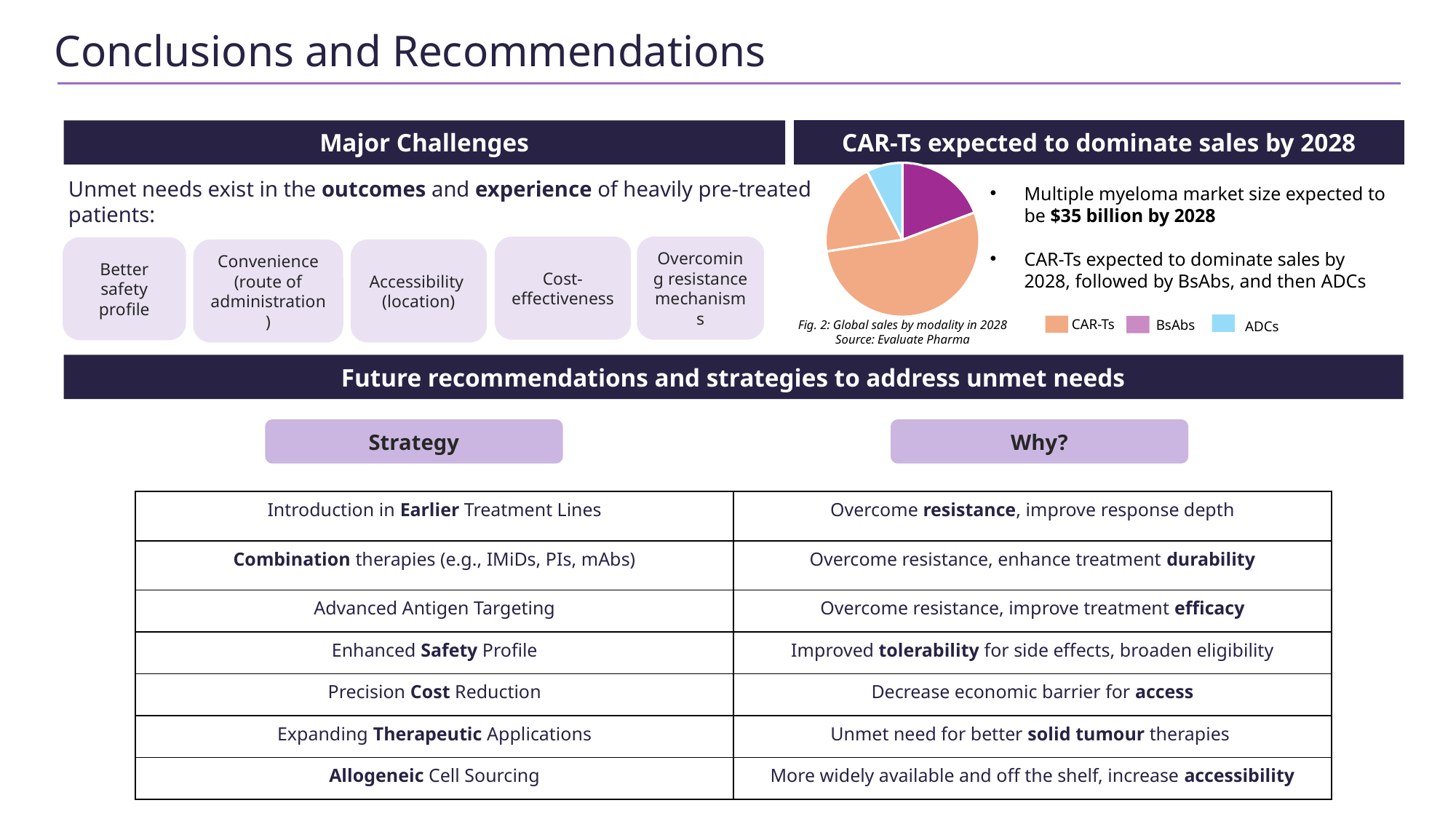
What is the caption of the pie chart (Fig. 2)? Global sales by modality in 2028 Which modality has the largest slice in the pie chart? CAR-Ts In the pie chart, which slice is larger: CAR-Ts or BsAbs? CAR-Ts Which modality has the smallest slice in the pie chart? ADCs What kind of chart is shown under the heading "CAR-Ts expected to dominate sales by 2028"? pie chart How many entries does the pie chart's legend list? 3 How many slices does the pie chart have? 4 In the pie chart, which slice is larger: BsAbs or ADCs? BsAbs What colour represents ADCs in the pie chart legend? light blue